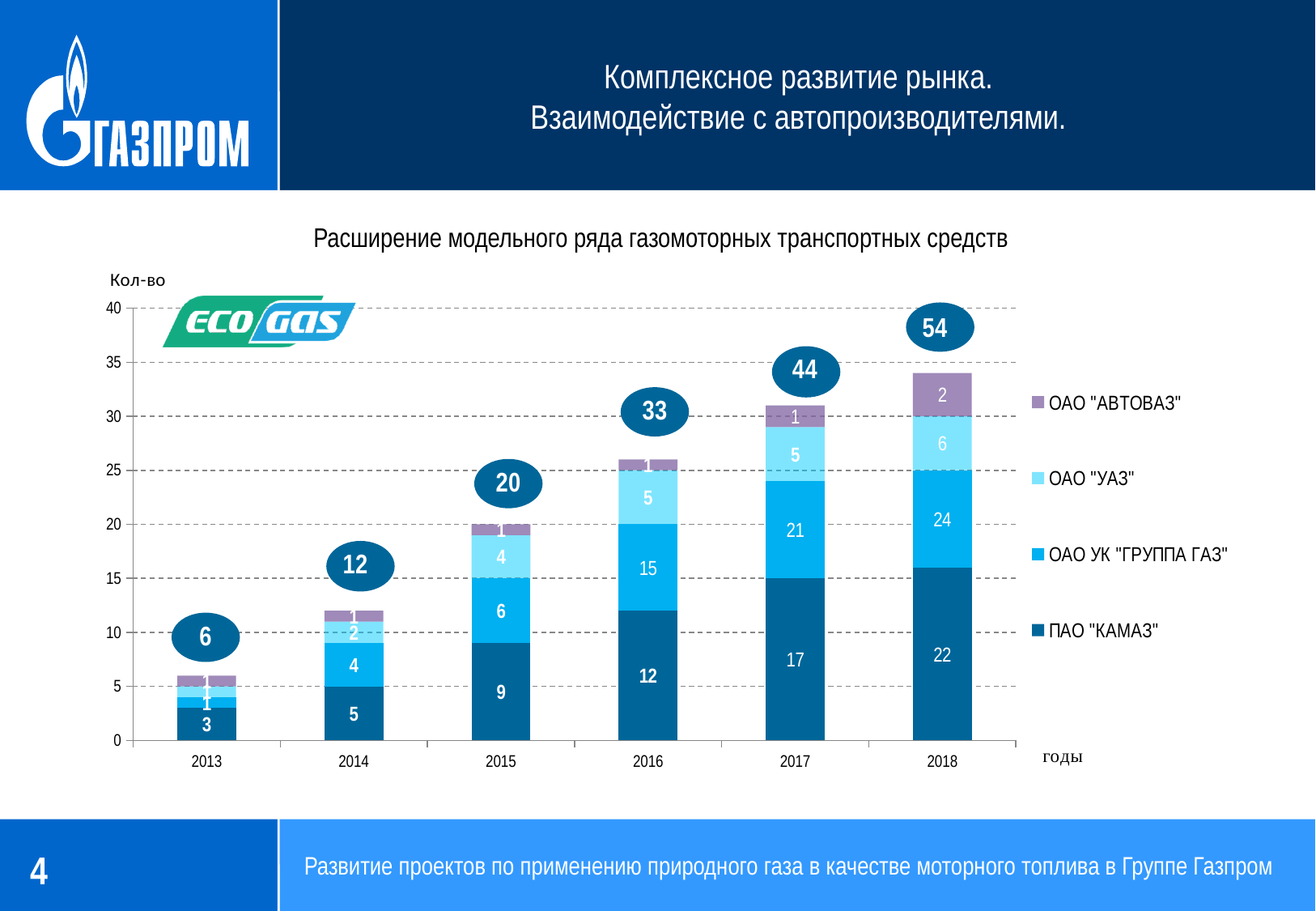
What is the value for ОАО "УАЗ" in 2015? 4 In 2016, which is larger: the value for ПАО "КАМАЗ" or for ОАО УК "ГРУППА ГАЗ"? ОАО УК "ГРУППА ГАЗ" How many years are shown on the x axis? 6 What is the value for ПАО "КАМАЗ" in 2018? 22 Which year has the highest total? 2018 What is the difference between the totals for 2018 and 2017? 10 Which year has the lowest total? 2013 What type of chart is shown on the slide? stacked bar chart What is the total shown above the bar for 2016? 33 Do the totals rise or fall from 2013 to 2018? rise What is the value for ОАО УК "ГРУППА ГАЗ" in 2017? 21 How many series does the legend list? 4